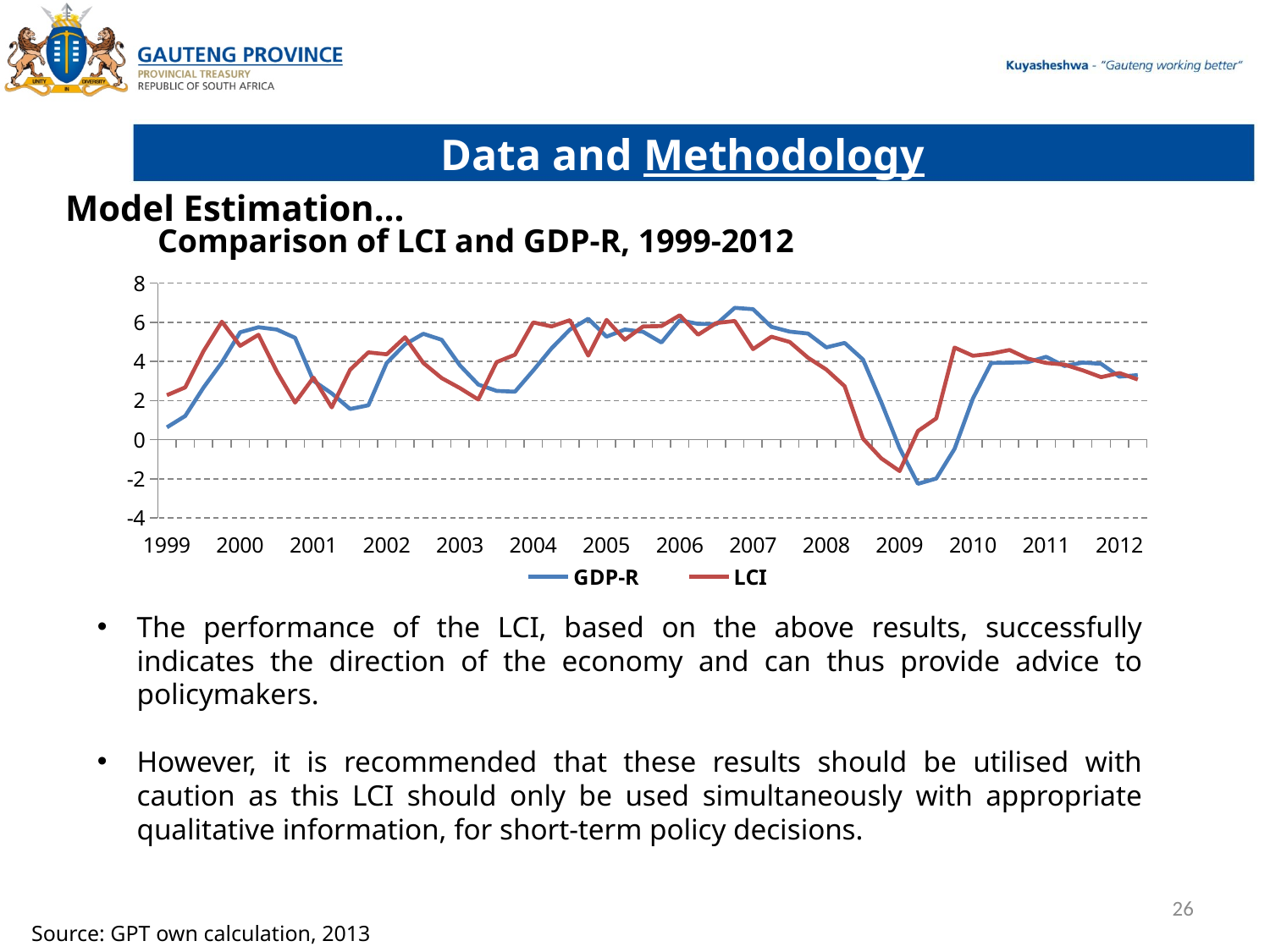
Which colour is used for the LCI line in the chart? Red What kind of chart is shown on the slide? Line chart Is the GDP-R value at the end of 2012 greater or less than 4? less How many series does the chart legend list? 2 Do the GDP-R and LCI lines rise or fall between 2008 and 2009? Fall At the start of 1999, which series has the higher value, GDP-R or LCI? LCI Is the lowest GDP-R value, reached around 2009, greater or less than 0? less How many year labels are shown along the x axis of the chart? 14 Is the GDP-R value at the start of 1999 greater or less than 2? less Around the 2007 peak, which series has the higher value, GDP-R or LCI? GDP-R What is the title of the chart? Comparison of LCI and GDP-R, 1999-2012